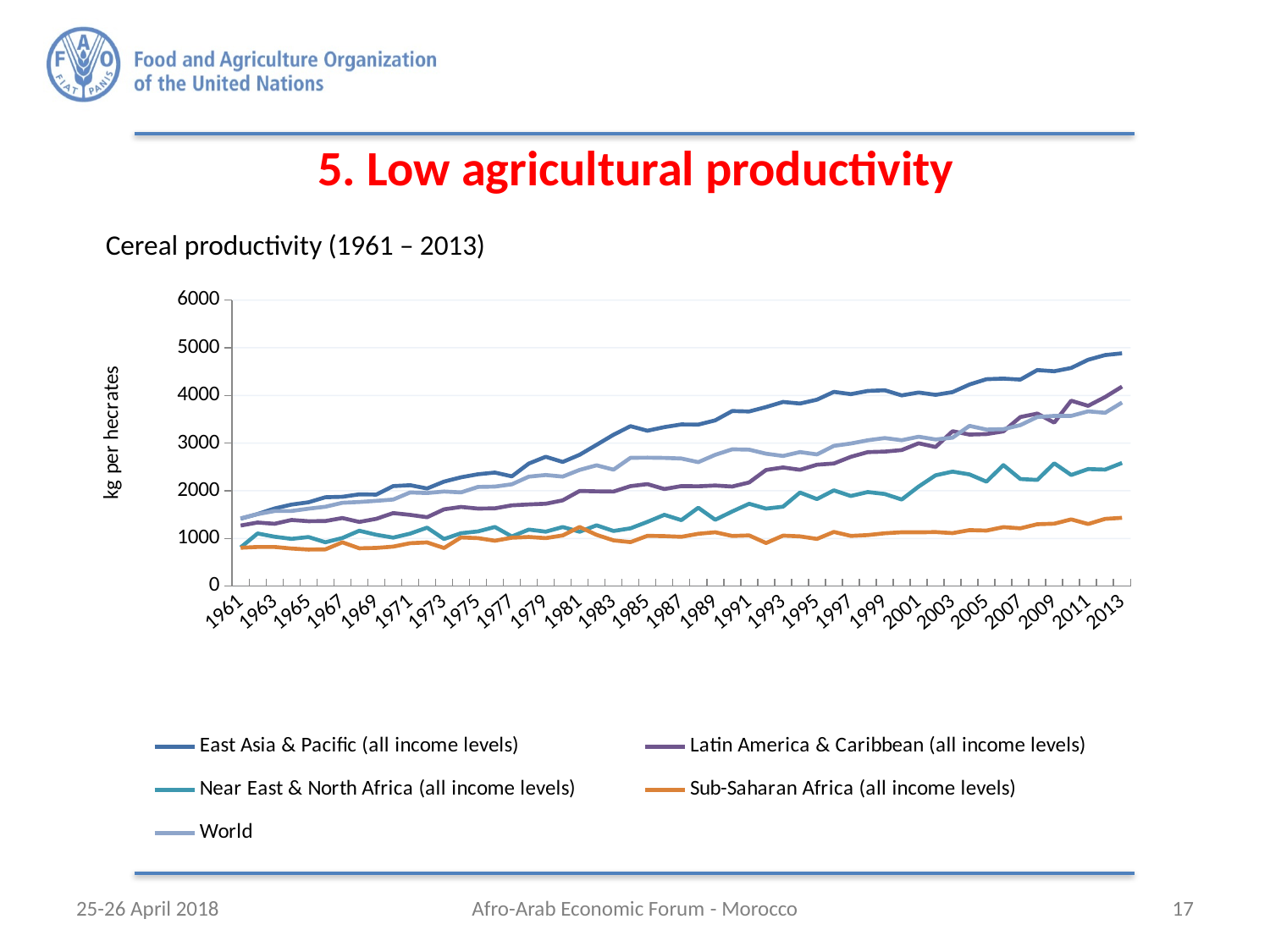
Is the value for East Asia & Pacific in 2013 greater or less than 4000? greater Which series has the highest value in 2013? East Asia & Pacific (all income levels) Is the value for World in 1961 greater or less than 2000? less What kind of chart is shown on the slide? Line chart What is the label on the vertical axis of the chart? kg per hecrates Is the value for Near East & North Africa in 2013 greater or less than 2000? greater In 2013, which is larger: the value for Latin America & Caribbean or the value for Sub-Saharan Africa? Latin America & Caribbean (all income levels) Which series has the lowest value in 2013? Sub-Saharan Africa (all income levels) What is the title of the chart? Cereal productivity (1961 – 2013) How many series does the legend list? 5 Does the East Asia & Pacific series generally rise or fall from 1961 to 2013? Rise